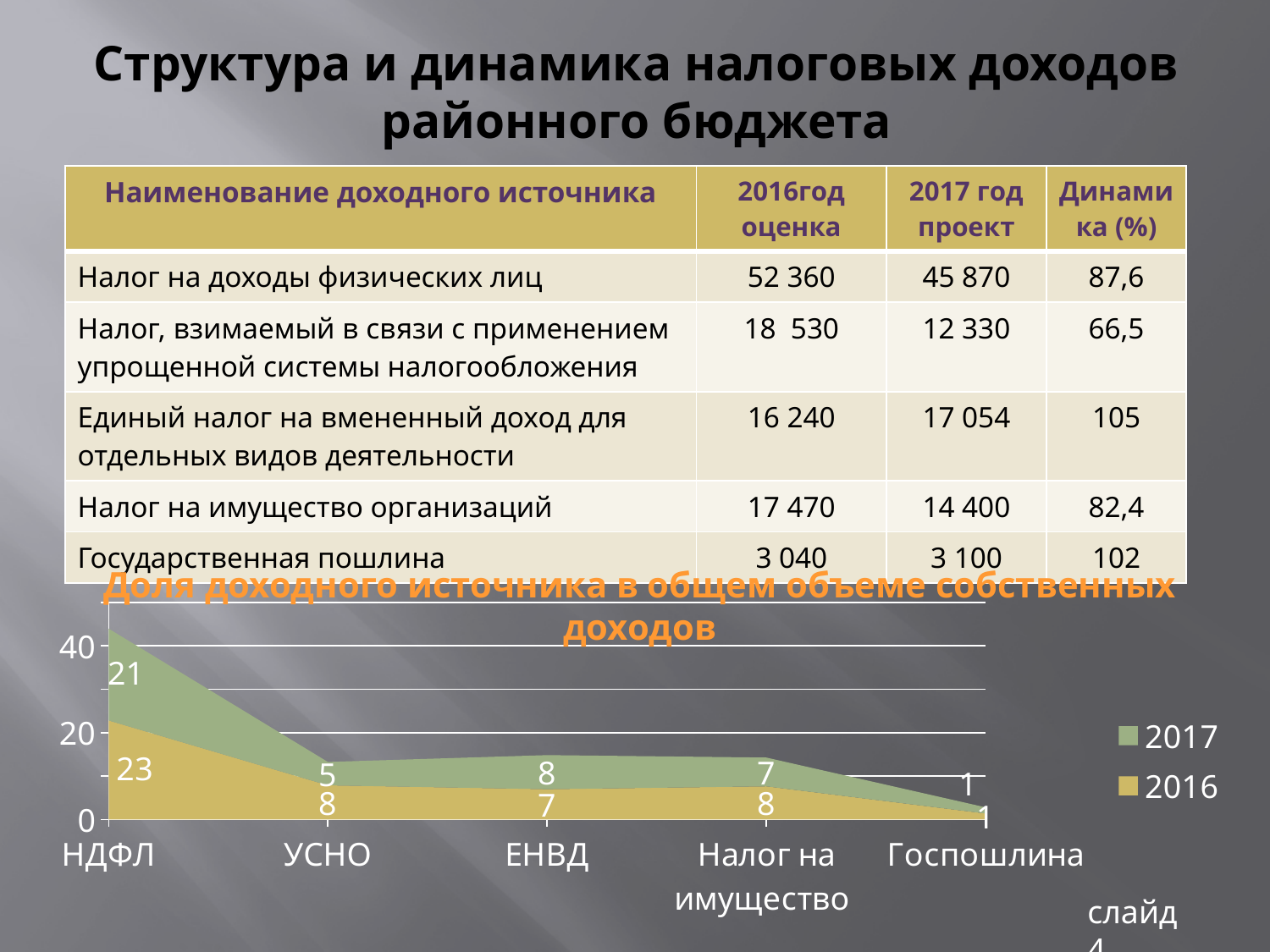
What is the title of the chart? Доля доходного источника в общем объеме собственных доходов How many categories are shown on the x axis of the chart? 5 What kind of chart is shown below the table on the slide? area chart How many series does the legend of the chart list? 2 Which category has the highest 2016 value in the chart? НДФЛ Which category has the lowest 2017 value in the chart? Госпошлина What is the combined (stacked) total of the 2016 and 2017 values for НДФЛ in the chart? 44 What is the 2017 value for УСНО in the chart? 5 For ЕНВД, which series has the larger value in the chart, 2016 or 2017? 2017 What is the difference between the 2016 and 2017 values for УСНО in the chart? 3 What is the 2016 value for НДФЛ in the chart? 23 What is the 2016 value for Налог на имущество in the chart? 8